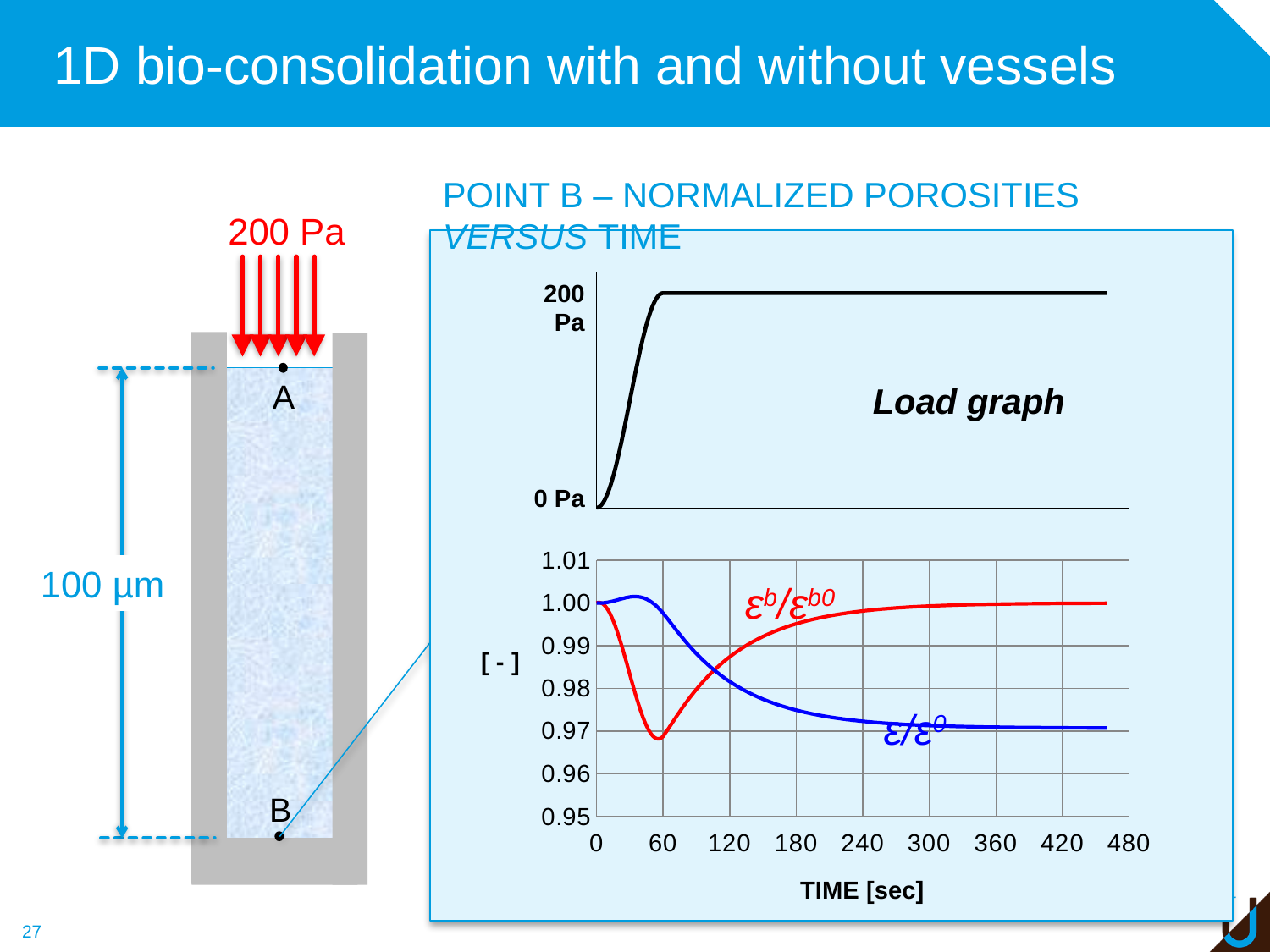
What type of chart is the bottom chart (normalized porosities versus time)? line chart In the bottom chart, which quantity is plotted by the red curve? ε^b/ε^b0 In the bottom chart, at 420 seconds, which curve has the larger value, the red (ε^b/ε^b0) or the blue (ε/ε^0)? red (ε^b/ε^b0) In the bottom chart, is the value of the blue curve (ε/ε^0) at 420 seconds greater or less than 0.98? less In the bottom chart, at 60 seconds, which curve has the larger value, the red (ε^b/ε^b0) or the blue (ε/ε^0)? blue (ε/ε^0) In the top chart (Load graph), how does the load change over time? rises then stays constant What is the x-axis label of the bottom chart? TIME [sec] In the top chart (Load graph), what load value does the curve plateau at? 200 Pa In the bottom chart, does the blue curve (ε/ε^0) overall rise or fall as time increases? fall In the bottom chart, is the value of the red curve (ε^b/ε^b0) at 60 seconds greater or less than 0.98? less In the bottom chart, is the value of the red curve (ε^b/ε^b0) at 300 seconds greater or less than 0.99? greater In the bottom chart, how many curves are plotted? 2